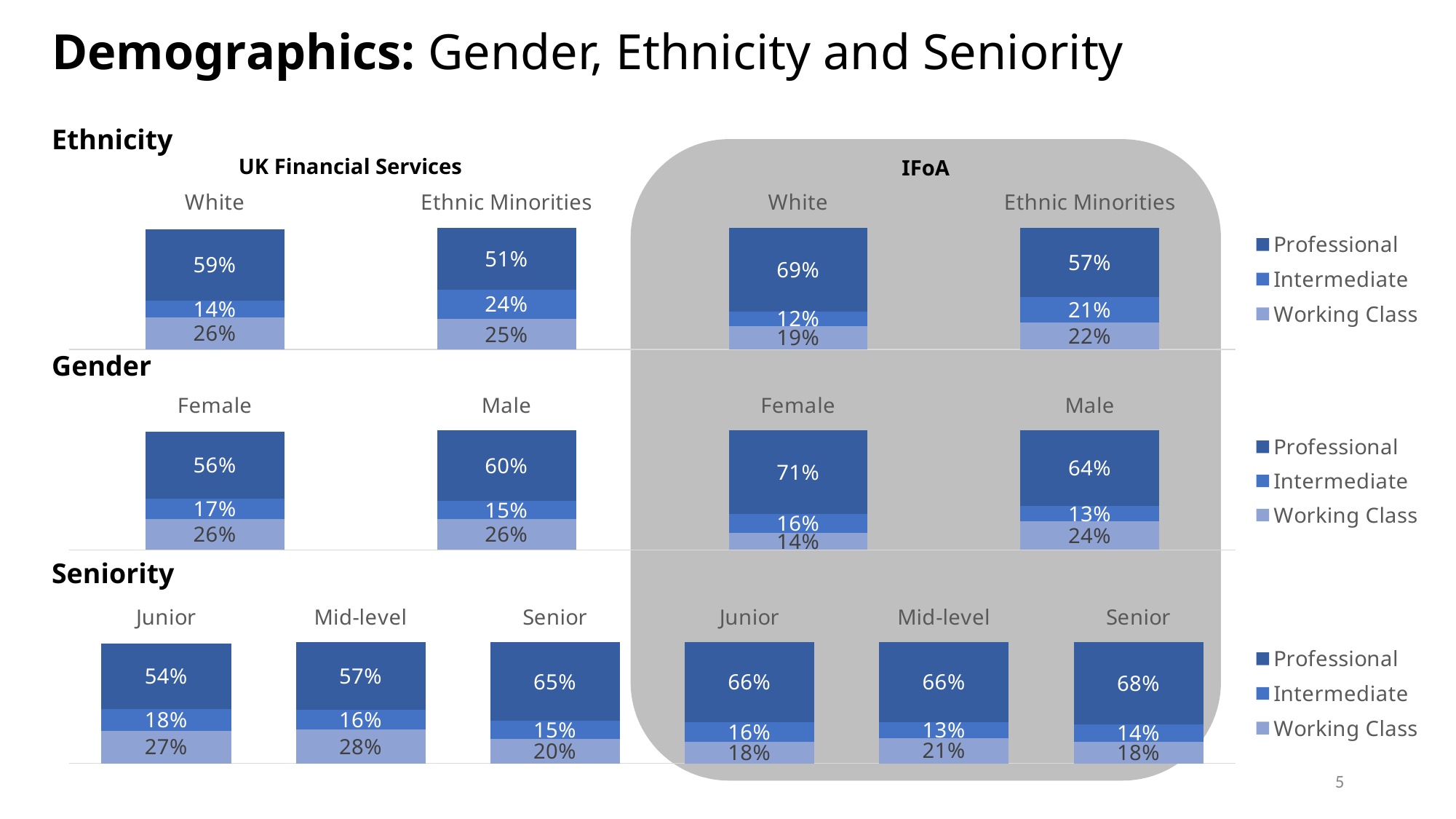
In the Ethnicity chart, what is the Professional share for White in the IFoA group? 69% How many categories are shown in the Seniority chart across both groups? 6 In the Ethnicity chart, what is the Working Class share for Ethnic Minorities in UK Financial Services? 25% In the Seniority chart, what is the total of the Working Class and Intermediate shares for Senior in IFoA? 32% In the Seniority chart, which UK Financial Services category has the lowest Professional share? Junior In the Seniority chart, what is the Working Class share for Mid-level in UK Financial Services? 28% What kind of chart is used in the Ethnicity section? Stacked bar chart In the Seniority chart, which IFoA category has the highest Professional share? Senior In the Gender chart, what is the difference between the Professional share for Female in IFoA and Female in UK Financial Services? 15% In the Ethnicity chart, which is larger: the Intermediate share for Ethnic Minorities in UK Financial Services or in IFoA? UK Financial Services How many series does the legend of the Gender chart list? 3 In the Gender chart, what is the Intermediate share for Male in the IFoA group? 13%